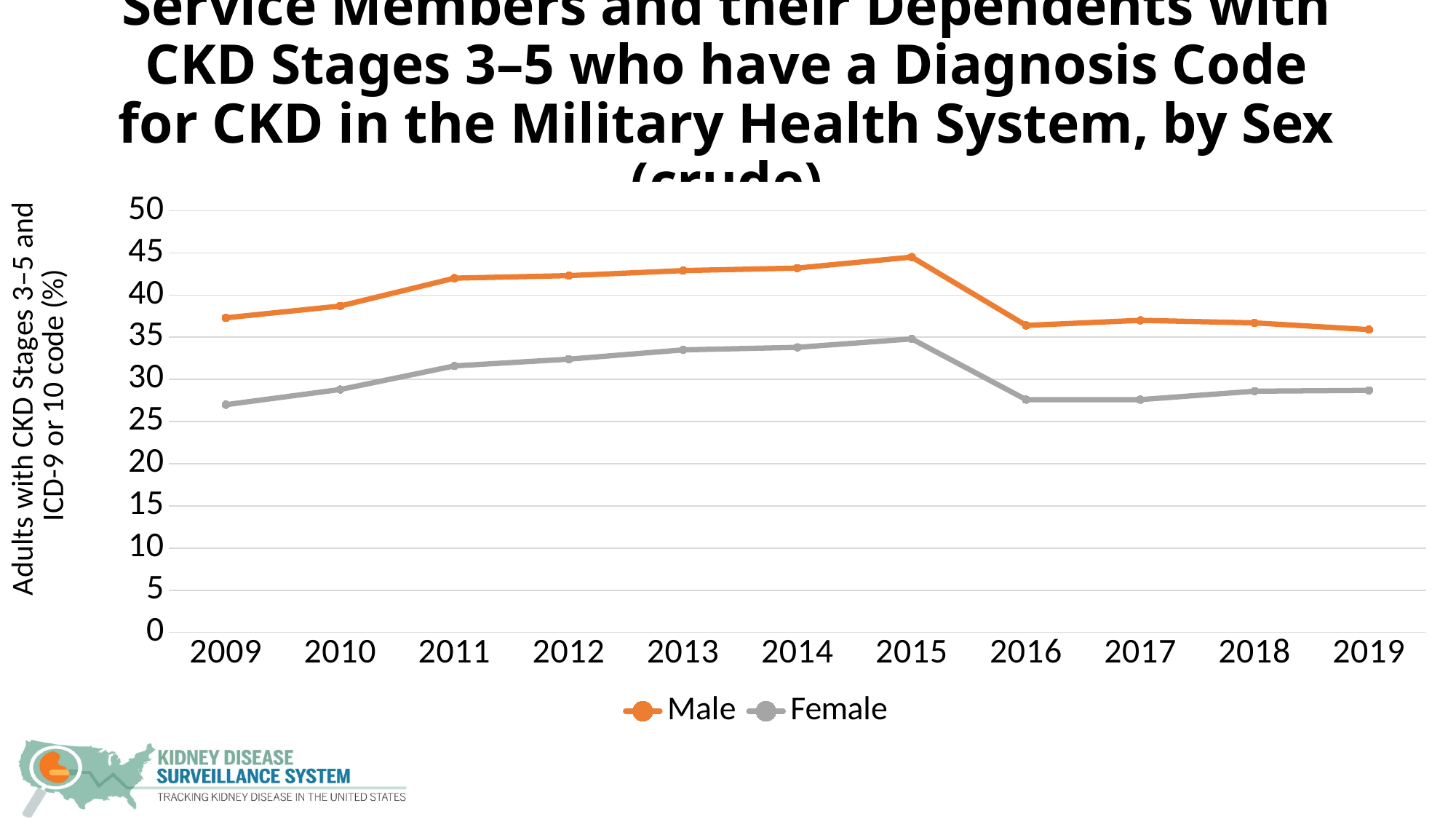
How many series does the legend list? 2 Which colour is used for the Male series in the legend? orange In which year does the Male series reach its highest value? 2015 Is the value for Male in 2015 greater or less than 40? greater Is the value for Male in 2016 greater or less than 40? less How many years are plotted along the x axis? 11 What kind of chart is shown on the slide? line chart Does the Male series rise or fall from 2009 to 2015? rise Is the value for Female in 2009 greater or less than 30? less In which year does the Female series reach its highest value? 2015 Which series has the larger value in 2012, Male or Female? Male